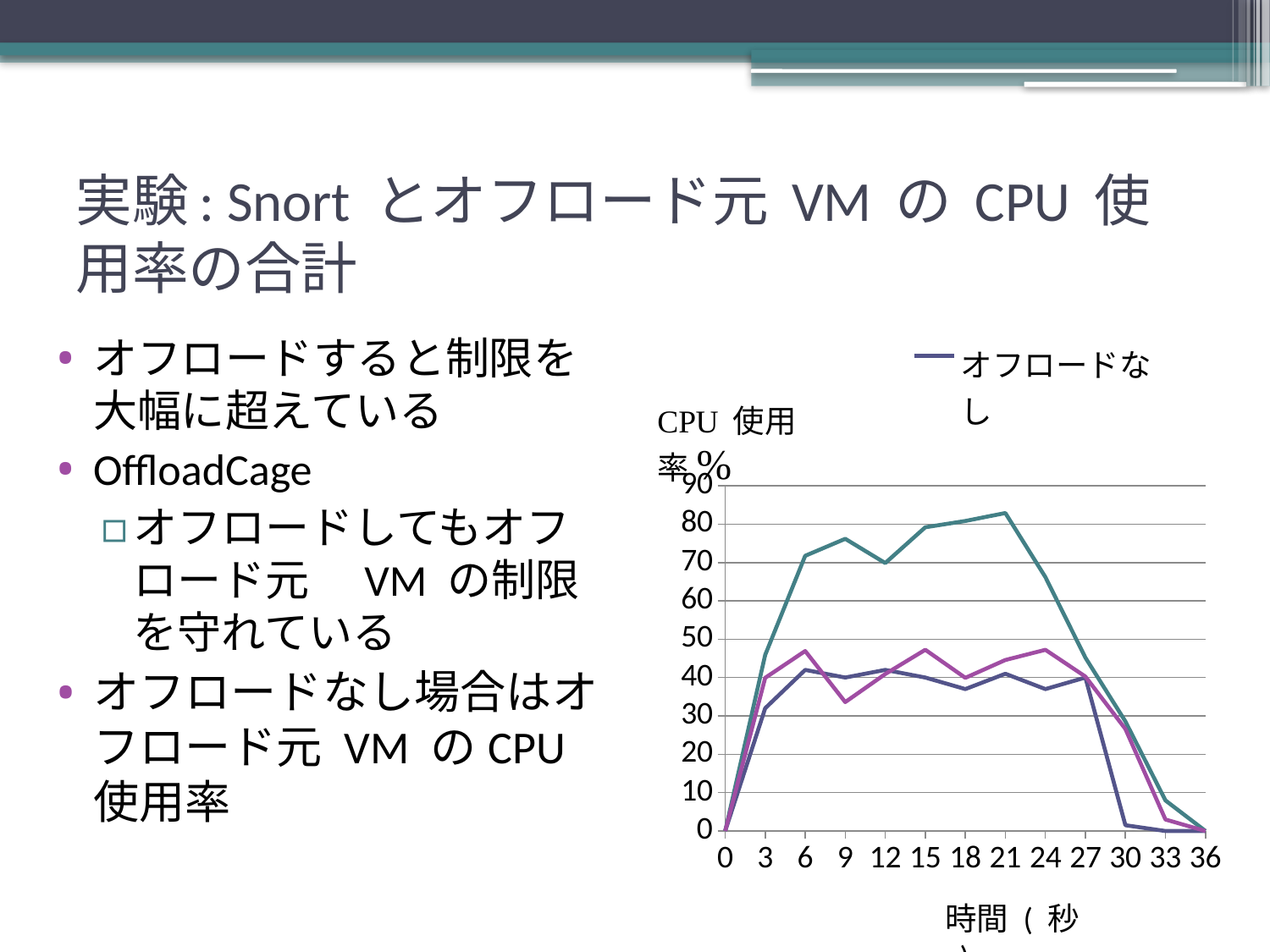
At which time does the teal line reach its highest value? 21 At time 21, which line is higher: the teal line or the オフロードなし line? the teal line How many time points are marked on the x axis of the chart? 13 What is the label of the y axis of the chart? CPU 使用率 % What kind of chart is shown on the slide? line chart Is the value of the teal line at time 21 greater or less than 80? greater Which series name is readable in the chart's legend? オフロードなし Do the values of the teal line rise or fall between time 27 and time 36? fall What is the value of the オフロードなし series at time 0? 0 Is the value of the オフロードなし series at time 30 greater or less than 10? less What is the value of the オフロードなし series at time 36? 0 Is the value of the magenta line at time 9 greater or less than 40? less